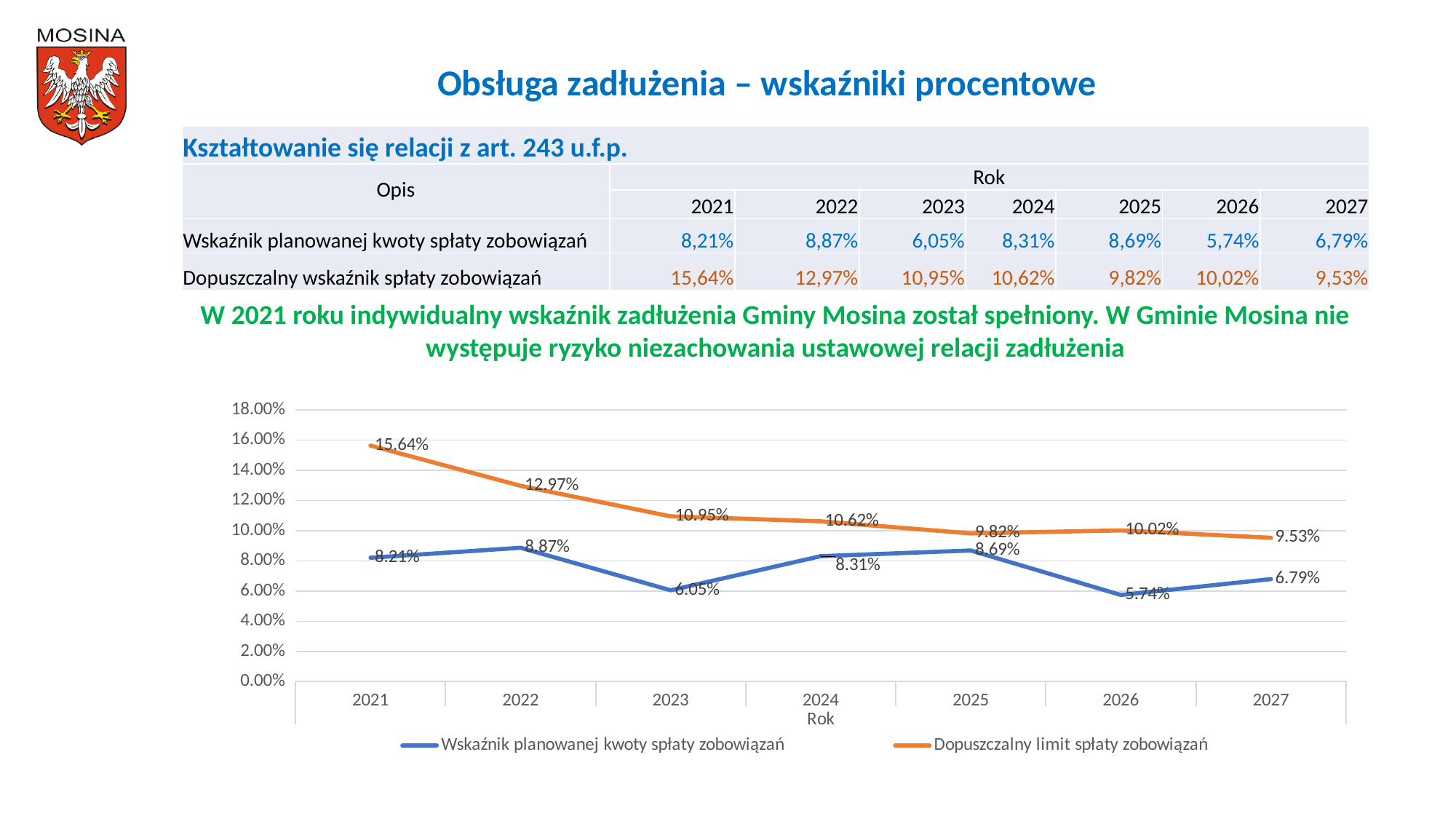
Does Dopuszczalny limit spłaty zobowiązań generally rise or fall from 2021 to 2027? fall Which is larger in 2025: Wskaźnik planowanej kwoty spłaty zobowiązań or Dopuszczalny limit spłaty zobowiązań? Dopuszczalny limit spłaty zobowiązań How many series does the chart legend list? 2 In which year is Wskaźnik planowanej kwoty spłaty zobowiązań lowest? 2026 In which year is Dopuszczalny limit spłaty zobowiązań highest? 2021 What is the value of Wskaźnik planowanej kwoty spłaty zobowiązań in 2023? 6.05% What is the value of Dopuszczalny limit spłaty zobowiązań in 2026? 10.02% How many years are plotted along the x axis of the chart? 7 What colour is the line for Dopuszczalny limit spłaty zobowiązań? orange What is the difference between Dopuszczalny limit spłaty zobowiązań and Wskaźnik planowanej kwoty spłaty zobowiązań in 2027? 2.74% What is the difference between Dopuszczalny limit spłaty zobowiązań and Wskaźnik planowanej kwoty spłaty zobowiązań in 2021? 7.43% What type of chart is shown on the slide? line chart